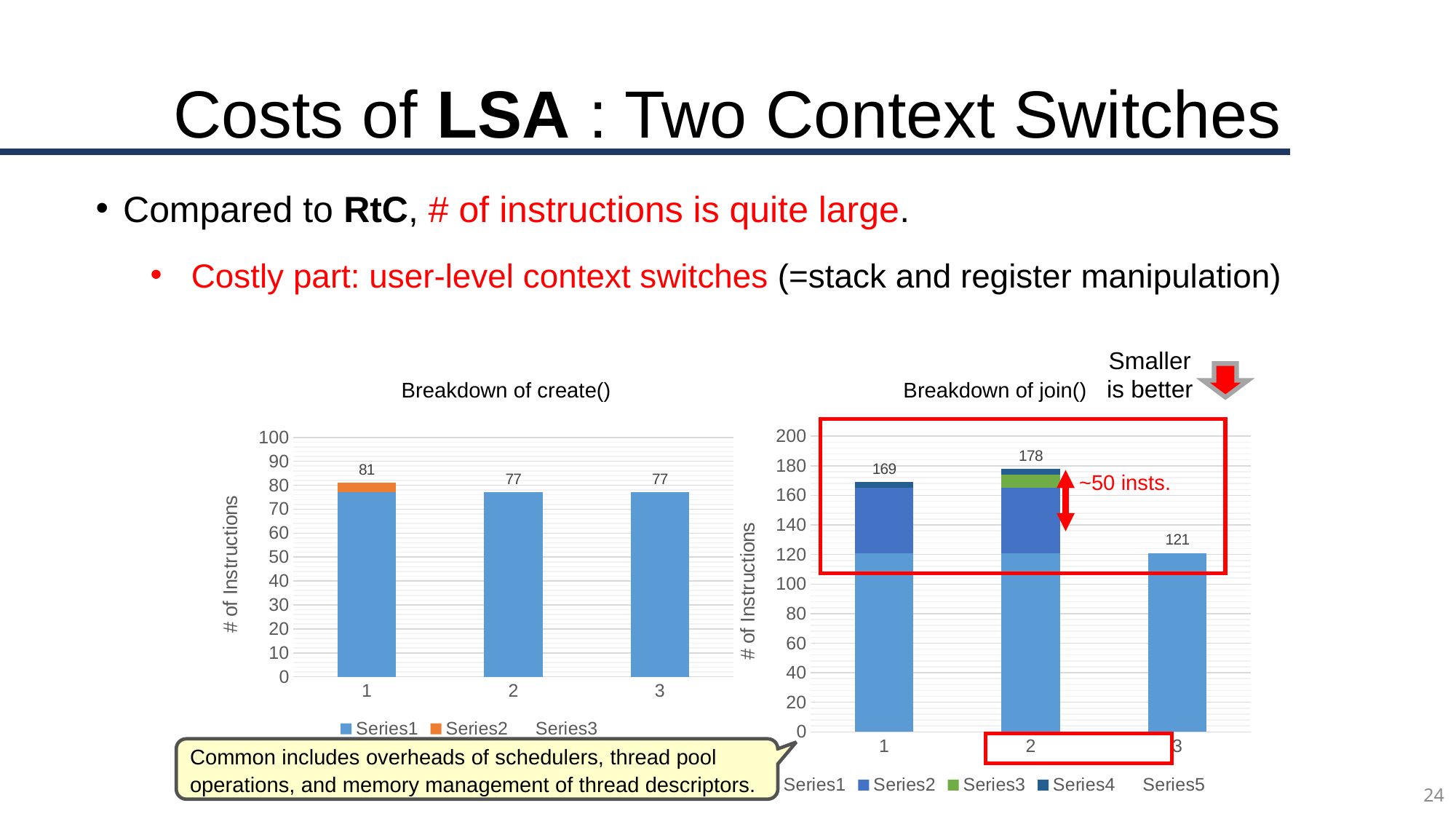
In the 'Breakdown of join()' chart, what is the total value labeled for category 3? 121 In the 'Breakdown of create()' chart, what is the difference between the totals for category 1 and category 2? 4 In the 'Breakdown of create()' chart, what is the total value labeled for category 3? 77 In the 'Breakdown of create()' chart, what is the total value labeled for category 1? 81 In the 'Breakdown of join()' chart, how many series does the legend list? 5 In the 'Breakdown of join()' chart, which category has the lowest total? 3 What kind of chart is the 'Breakdown of join()' chart? stacked bar chart In the 'Breakdown of create()' chart, how many series does the legend list? 3 In the 'Breakdown of join()' chart, what is the difference between the totals for category 2 and category 3? 57 In the 'Breakdown of join()' chart, what is the total value labeled for category 2? 178 In the 'Breakdown of join()' chart, is the total for category 1 larger or smaller than the total for category 2? smaller In the 'Breakdown of create()' chart, which category has the highest total? 1